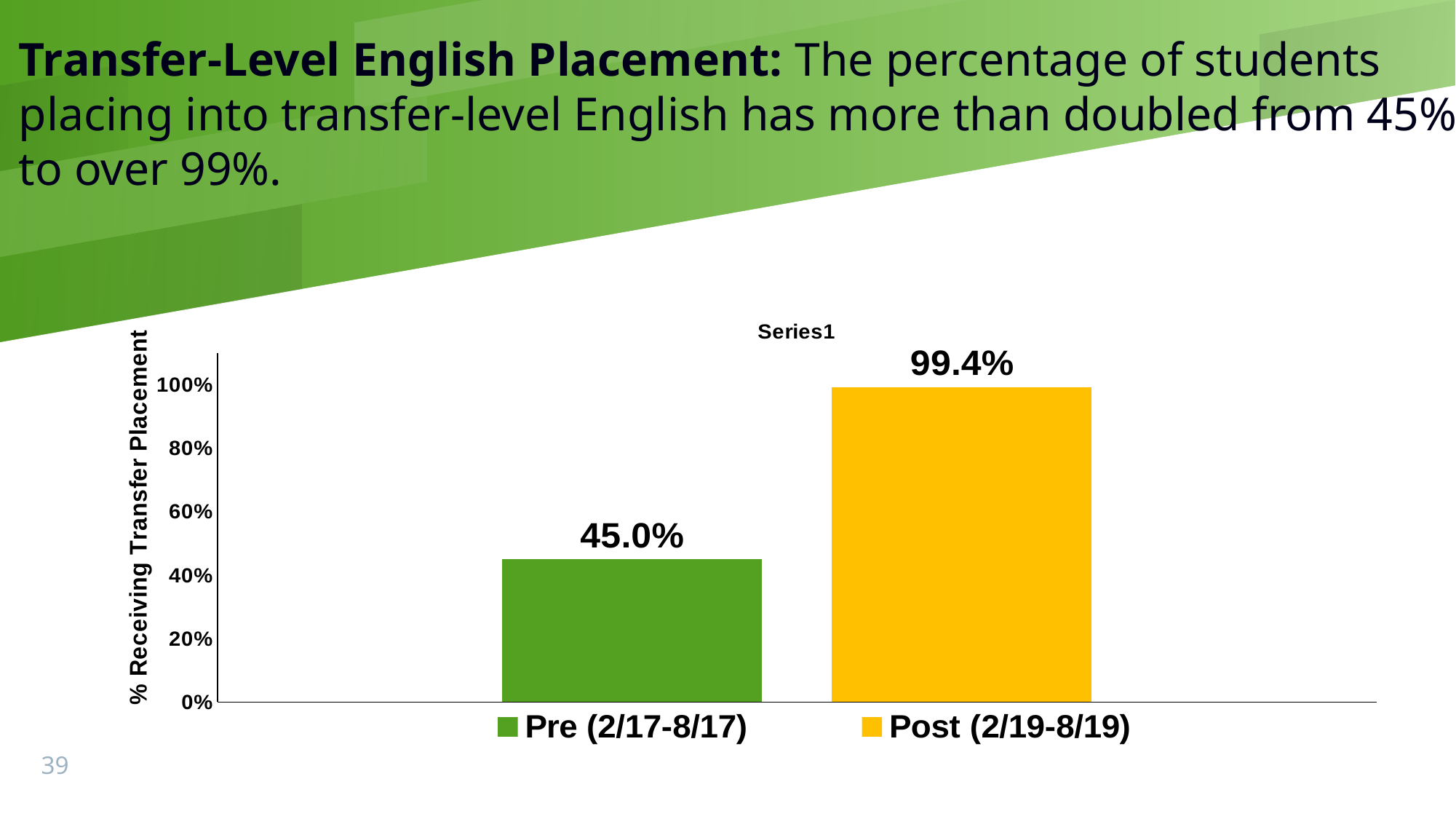
What kind of chart is shown on the slide? bar chart Which category has the lowest value? Pre (2/17-8/17) What is the value for Pre (2/17-8/17)? 45.0% What colour is the bar for Post (2/19-8/19)? yellow What is the difference between the Post (2/19-8/19) and Pre (2/17-8/17) values? 54.4% How many bars are plotted in the chart? 2 Which is larger, the value for Pre (2/17-8/17) or Post (2/19-8/19)? Post (2/19-8/19) Is the value for Post (2/19-8/19) greater or less than 80%? greater What is the label of the vertical axis? % Receiving Transfer Placement Which category has the highest value? Post (2/19-8/19) Is the value for Pre (2/17-8/17) greater or less than 60%? less What is the value for Post (2/19-8/19)? 99.4%